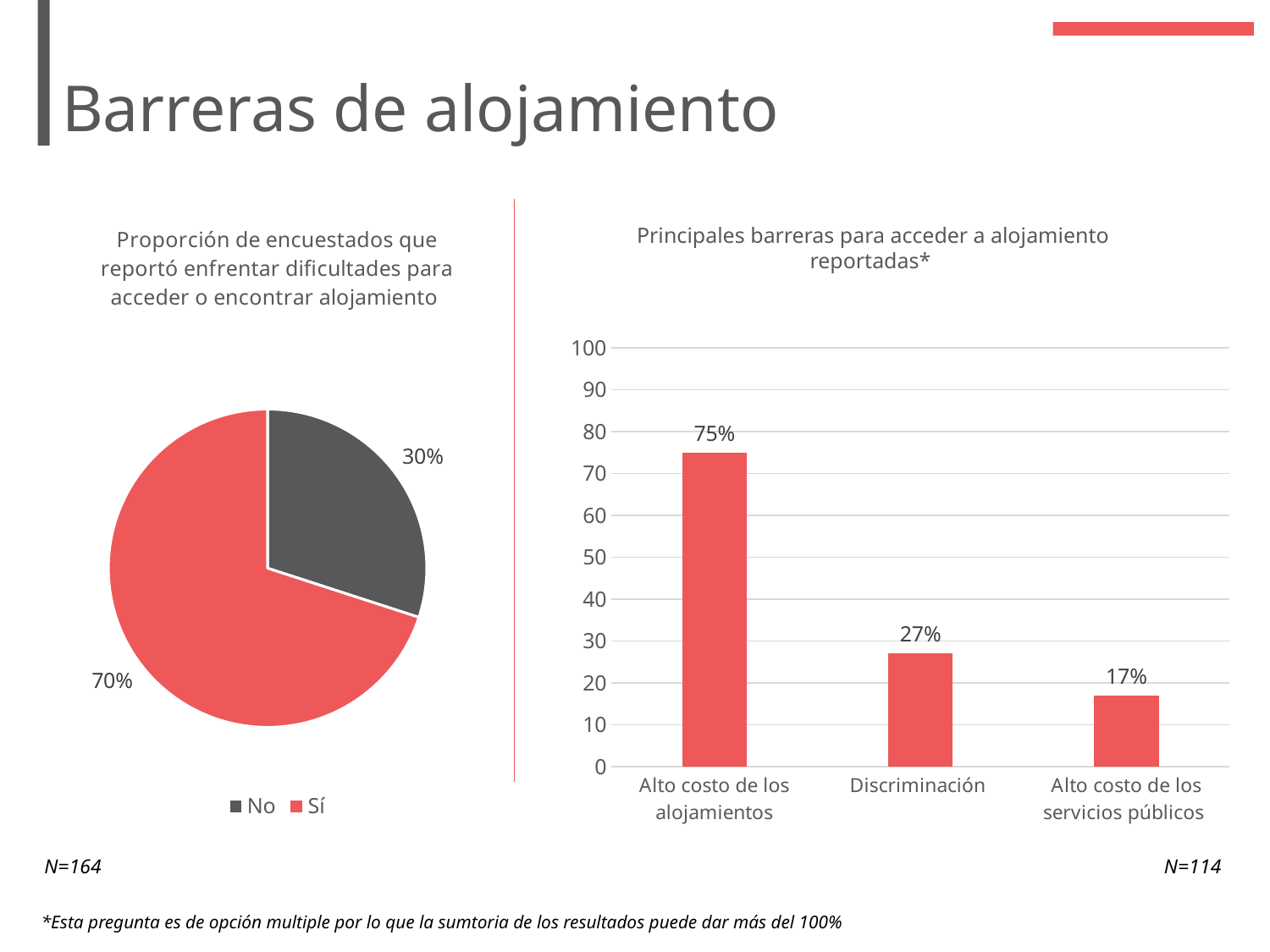
In the bar chart 'Principales barreras para acceder a alojamiento reportadas*', how many categories are shown? 3 In the bar chart 'Principales barreras para acceder a alojamiento reportadas*', what is the value for 'Alto costo de los servicios públicos'? 17% In the pie chart on the left, what share of respondents answered 'No'? 30% In the pie chart on the left, what share of respondents answered 'Sí'? 70% In the bar chart 'Principales barreras para acceder a alojamiento reportadas*', which category has the lowest value? Alto costo de los servicios públicos What kind of chart is the chart on the right? Bar chart In the pie chart on the left, how many entries does the legend list? 2 In the pie chart on the left, which response has the larger share, 'No' or 'Sí'? Sí In the bar chart 'Principales barreras para acceder a alojamiento reportadas*', what is the difference between 'Alto costo de los alojamientos' and 'Discriminación'? 48% What kind of chart is the chart on the left? Pie chart In the bar chart 'Principales barreras para acceder a alojamiento reportadas*', what is the value for 'Discriminación'? 27% In the bar chart 'Principales barreras para acceder a alojamiento reportadas*', which category has the highest value? Alto costo de los alojamientos